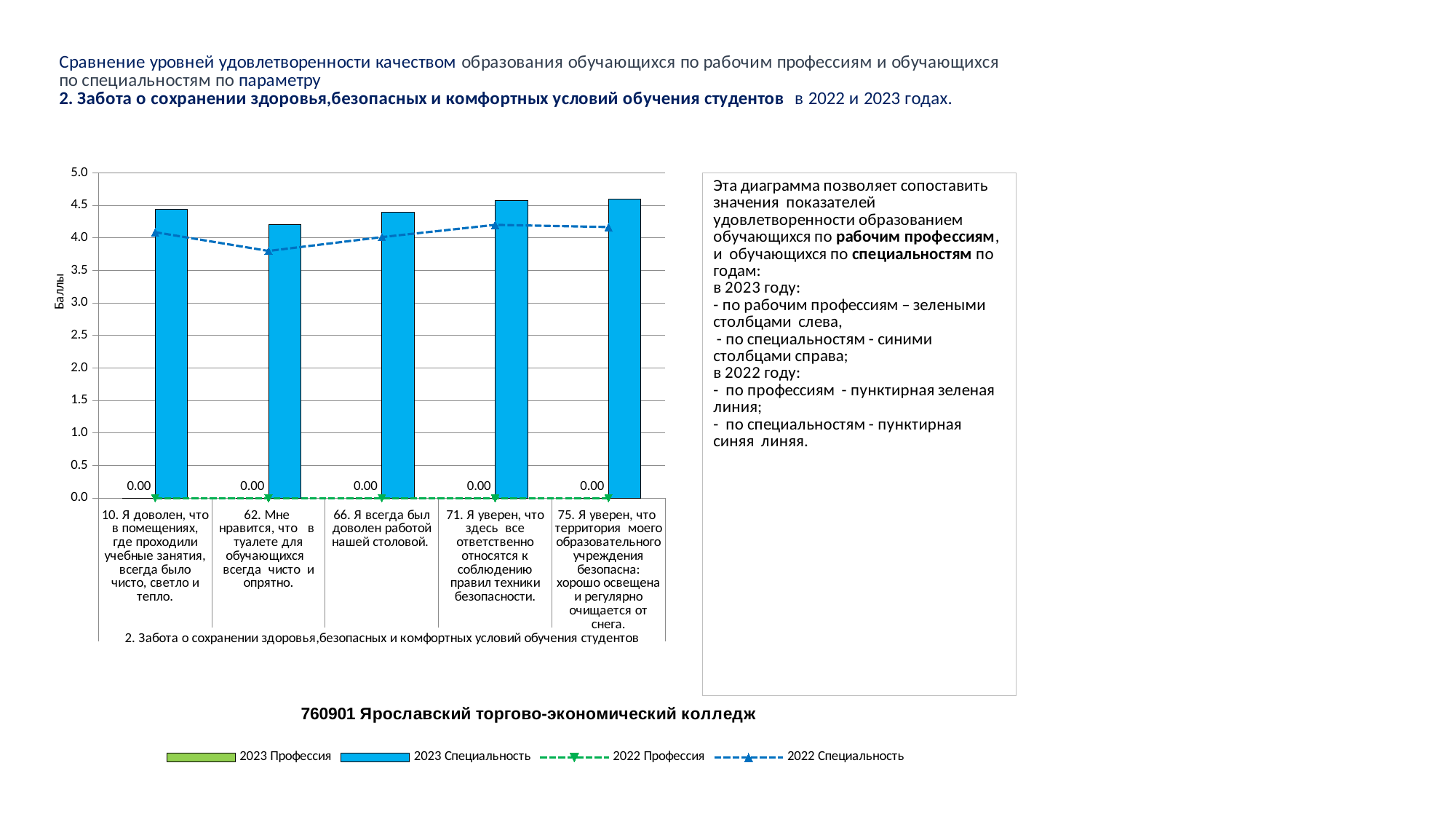
What is the value of the 2023 Профессия series for category "10. Я доволен, что в помещениях, где проходили учебные занятия, всегда было чисто, светло и тепло."? 0.00 For category 10, which is larger: the 2023 Специальность bar or the 2022 Специальность line point? 2023 Специальность Which category has the lowest point on the 2022 Специальность line? 62. Мне нравится, что в туалете для обучающихся всегда чисто и опрятно. Is the 2022 Специальность value for category 62 greater or less than 4.0? less What kind of chart is shown on the slide? Bar chart combined with line series What is the value of the 2023 Профессия series for category "75. Я уверен, что территория моего образовательного учреждения безопасна..."? 0.00 Which is larger: the 2023 Специальность value for category 71 or for category 62? Category 71 Is the 2023 Специальность value for category 62 greater or less than 4.0? greater How many series does the chart legend list? 4 How many categories are shown on the x axis of the chart? 5 Which category has the lowest 2023 Специальность bar? 62. Мне нравится, что в туалете для обучающихся всегда чисто и опрятно. What is the label of the vertical axis of the chart? Баллы